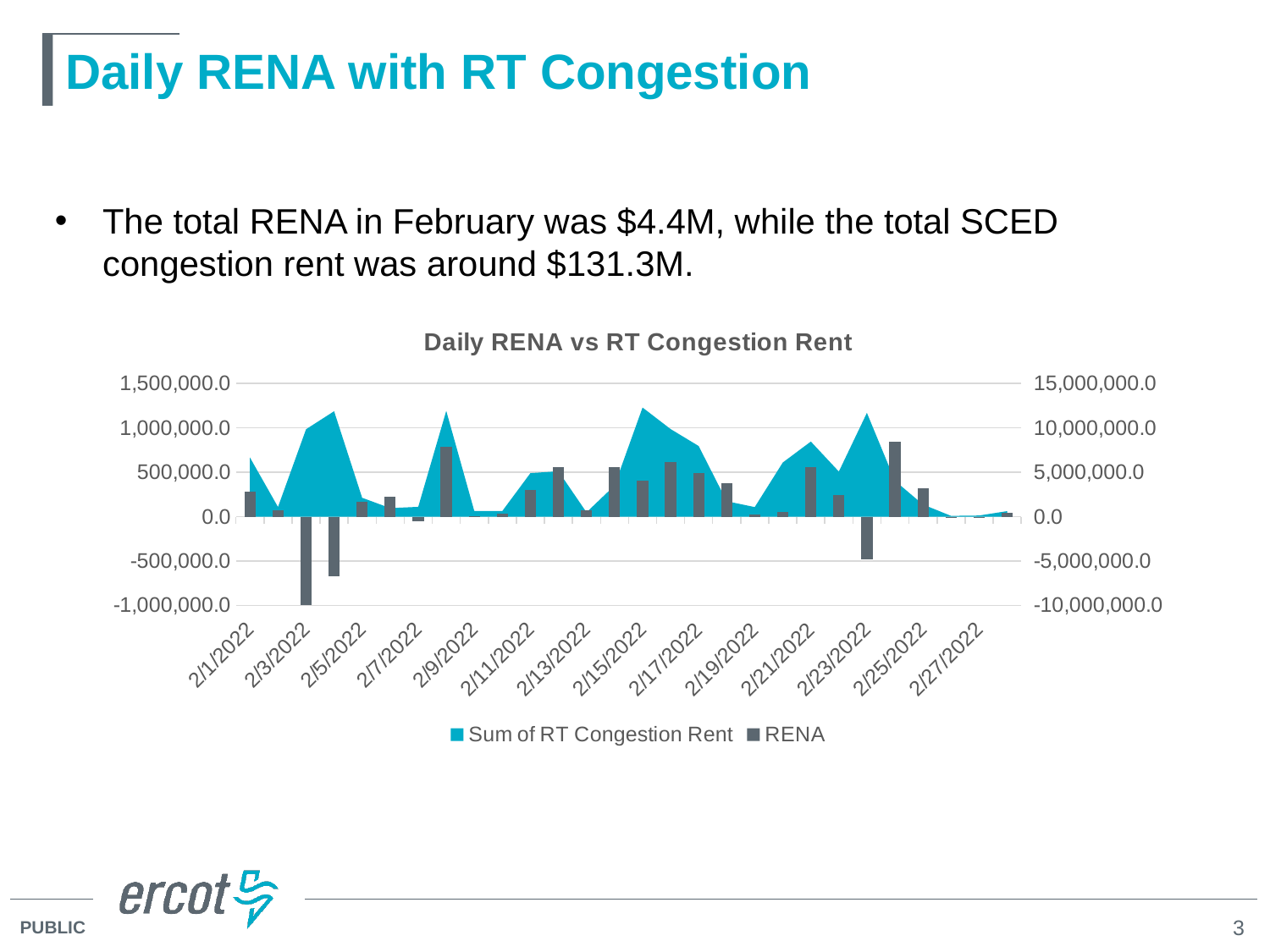
What kind of chart is used for the Sum of RT Congestion Rent series? Area chart What are the two series named in the chart legend? Sum of RT Congestion Rent and RENA What kind of chart is used for the RENA series? Bar chart How many date labels are shown on the x axis of the chart? 14 Does the Sum of RT Congestion Rent area rise or fall from 2/23/2022 to 2/27/2022? Fall What is the title of the chart on the slide? Daily RENA vs RT Congestion Rent Does the Sum of RT Congestion Rent area rise or fall from 2/13/2022 to 2/15/2022? Rise Is the RENA bar for 2/23/2022 positive or negative? Negative How many series does the chart legend list? 2 Is the value for Sum of RT Congestion Rent on 2/15/2022 greater or less than 15,000,000.0 on the right axis? Less On which date is the RENA bar the lowest (most negative)? 2/3/2022